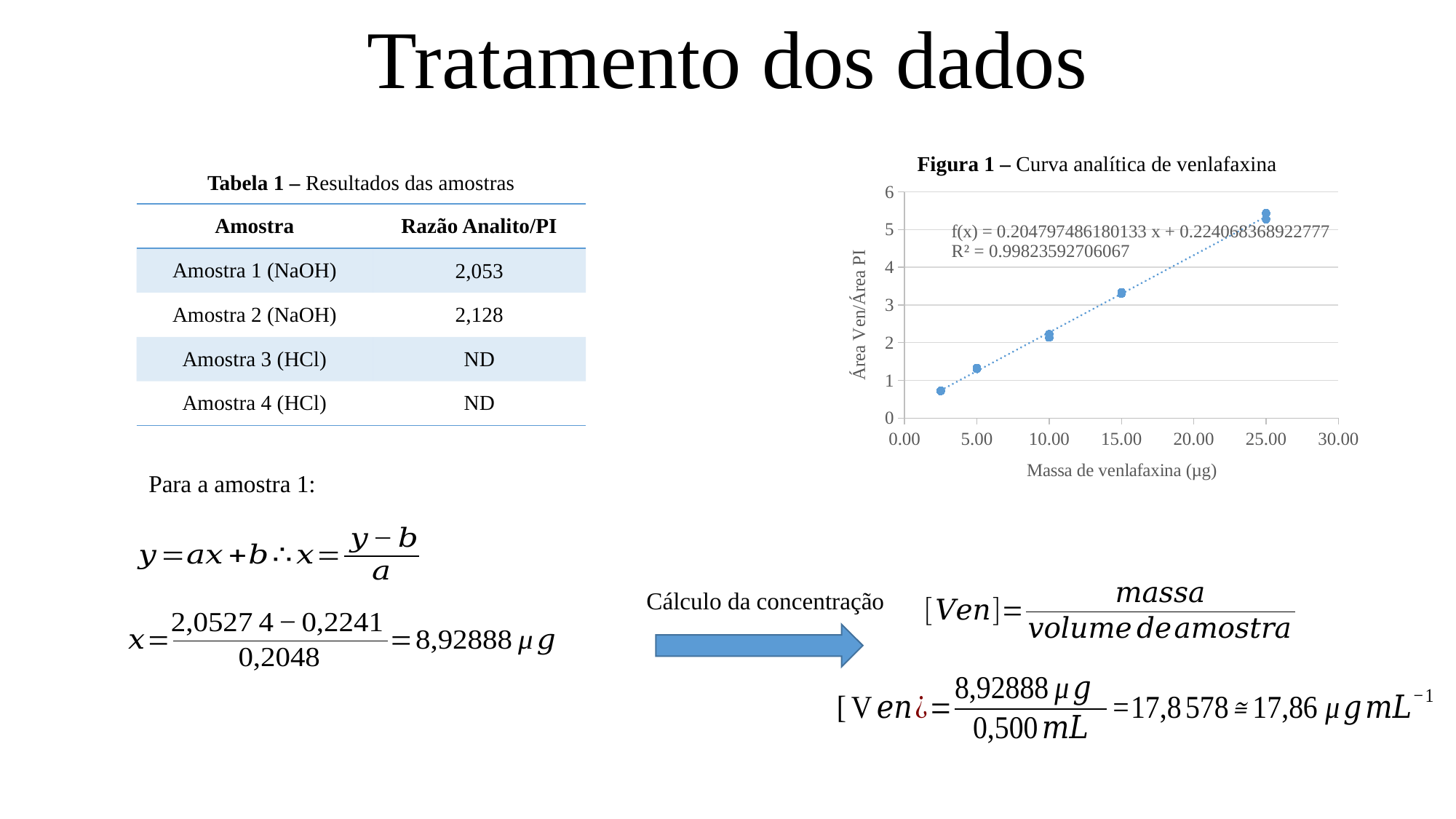
What R² value is printed on the chart for the trendline? 0.99823592706067 Is the Área Ven/Área PI value at a mass of 15.00 µg greater or less than 3? greater What kind of chart is shown in Figura 1? scatter chart Is the Área Ven/Área PI value larger at a mass of 15.00 µg or at 5.00 µg? 15.00 What is the maximum value shown on the y axis of the chart? 6 What is the title of the chart on the slide? Figura 1 – Curva analítica de venlafaxina Is the Área Ven/Área PI value at a mass of 25.00 µg greater or less than 5? greater Is the Área Ven/Área PI value at a mass of 10.00 µg greater or less than 3? less Do the plotted values rise or fall as the mass of venlafaxina increases along the x axis? rise What is the label of the x axis of the chart? Massa de venlafaxina (µg) Which mass of venlafaxina has the highest Área Ven/Área PI value in the chart? 25.00